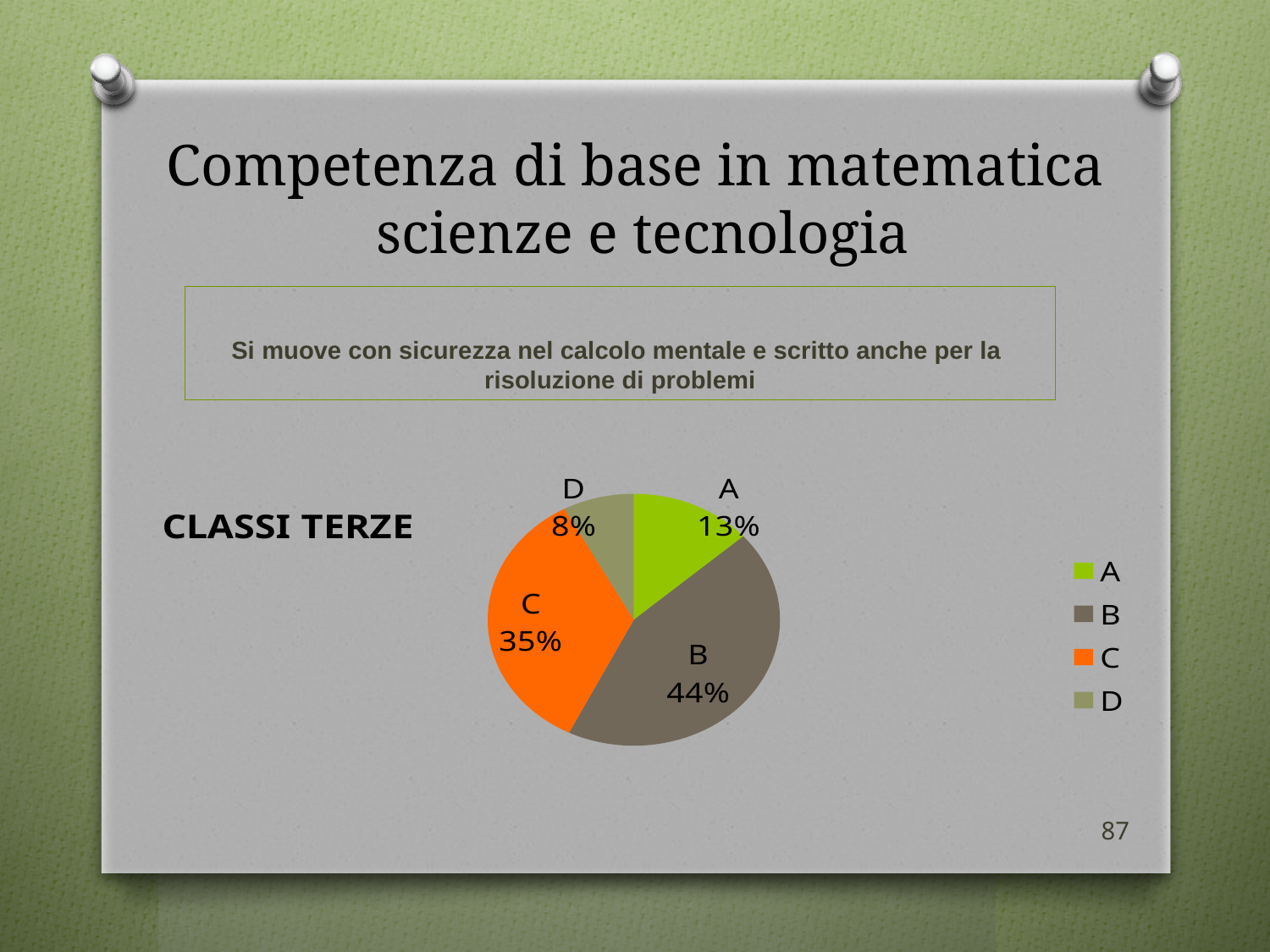
What is the difference in percentage points between slice B and slice C? 9 How many entries does the legend list? 4 What percentage does slice A represent in the pie chart? 13% Which is larger, slice A or slice D? A Which slice of the pie chart is the smallest? D What percentage does slice B represent in the pie chart? 44% What percentage does slice D represent in the pie chart? 8% Which slice of the pie chart is the largest? B What colour is slice C in the pie chart? orange What percentage does slice C represent in the pie chart? 35% How many slices does the pie chart have? 4 What kind of chart is shown on the slide? pie chart